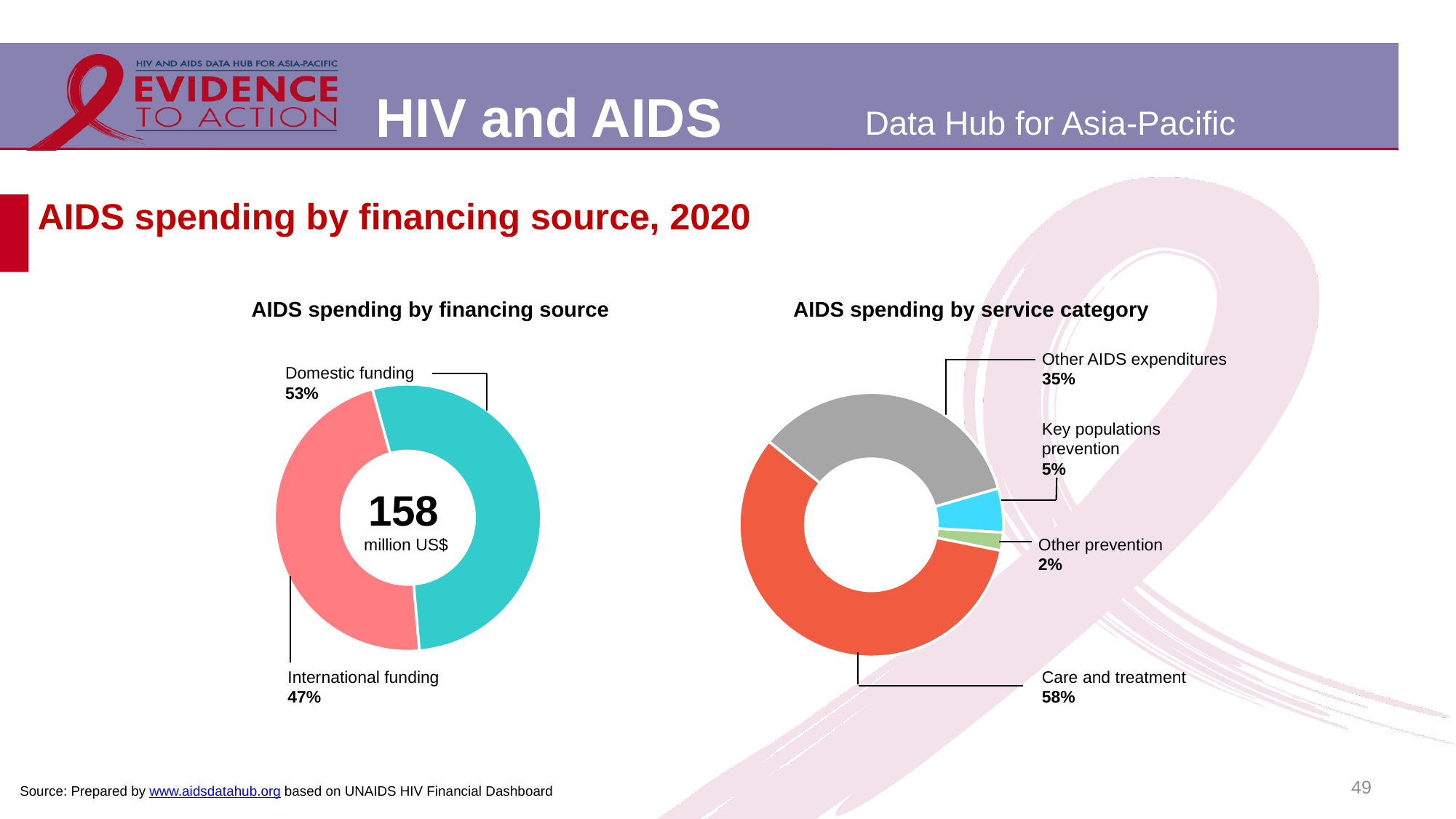
In the 'AIDS spending by service category' chart, what share is Other AIDS expenditures? 35% How many categories are shown in the 'AIDS spending by service category' chart? 4 In the 'AIDS spending by service category' chart, what share is Key populations prevention? 5% In the 'AIDS spending by financing source' chart, what is the difference in percentage points between Domestic funding and International funding? 6 percentage points In the 'AIDS spending by service category' chart, what is the difference in percentage points between Care and treatment and Other AIDS expenditures? 23 percentage points What kind of chart is 'AIDS spending by financing source'? Donut (pie) chart In the 'AIDS spending by financing source' chart, which source has the larger share? Domestic funding In the 'AIDS spending by financing source' chart, what share is International funding? 47% In the 'AIDS spending by service category' chart, which category has the smallest share? Other prevention In the 'AIDS spending by financing source' chart, what share is Domestic funding? 53% In the 'AIDS spending by service category' chart, what share is Care and treatment? 58% In the 'AIDS spending by financing source' chart, what total value is shown in the centre of the donut? 158 million US$